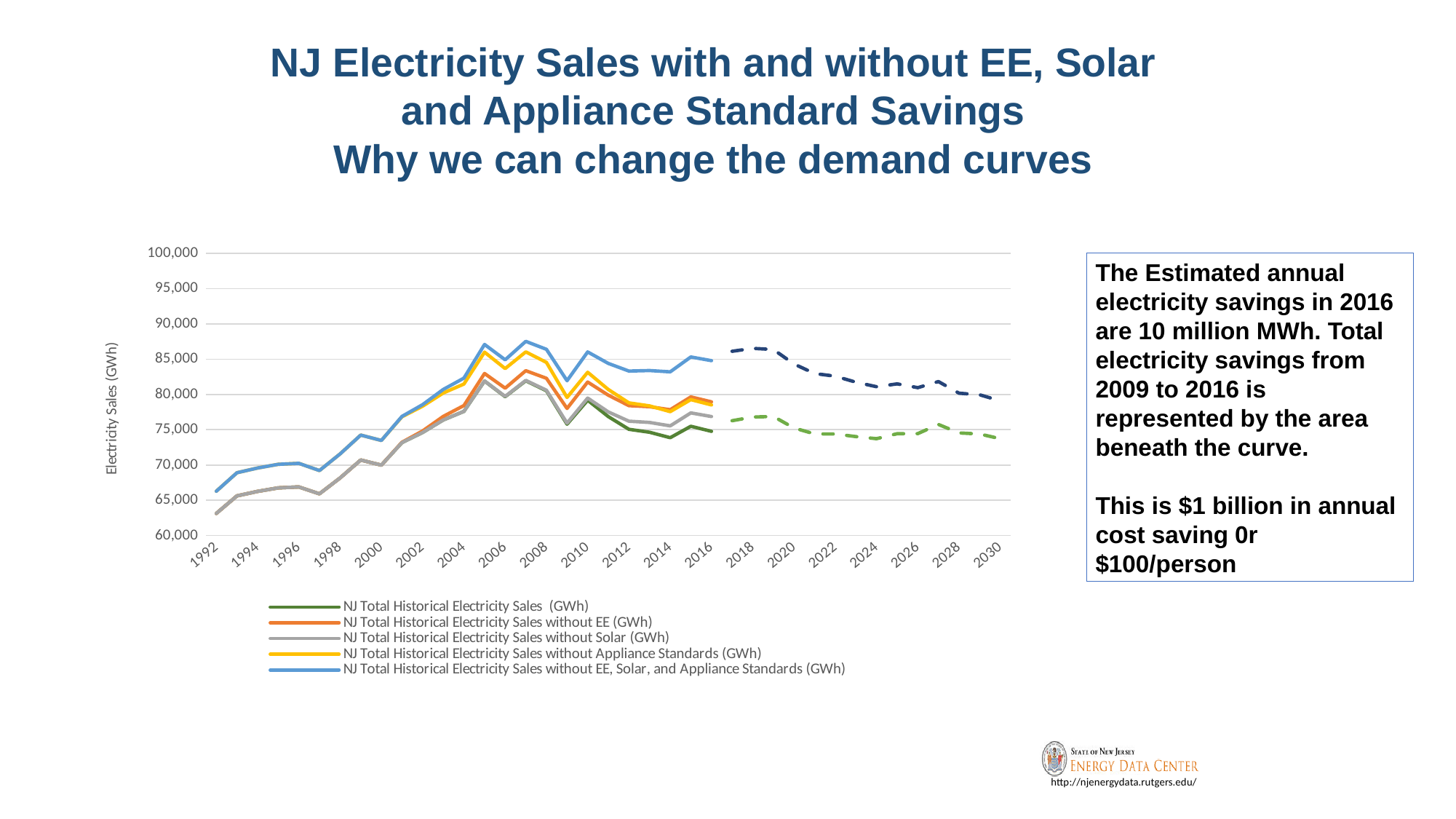
Which series is drawn in blue in the chart? NJ Total Historical Electricity Sales without EE, Solar, and Appliance Standards (GWh) Is the value of NJ Total Historical Electricity Sales without EE, Solar, and Appliance Standards (GWh) in 2007 greater or less than 85,000? greater Is the value of NJ Total Historical Electricity Sales without EE, Solar, and Appliance Standards (GWh) in 1992 greater or less than 65,000? greater In 2016, which is larger: NJ Total Historical Electricity Sales (GWh) or NJ Total Historical Electricity Sales without EE, Solar, and Appliance Standards (GWh)? NJ Total Historical Electricity Sales without EE, Solar, and Appliance Standards (GWh) Does NJ Total Historical Electricity Sales (GWh) rise or fall from 2010 to 2014? fall What kind of chart is shown on the slide? line chart Does NJ Total Historical Electricity Sales (GWh) rise or fall from 1992 to 2005? rise Is the value of NJ Total Historical Electricity Sales without Solar (GWh) in 1992 greater or less than 65,000? less How many series does the chart's legend list? 5 What is the label on the vertical axis of the chart? Electricity Sales (GWh)